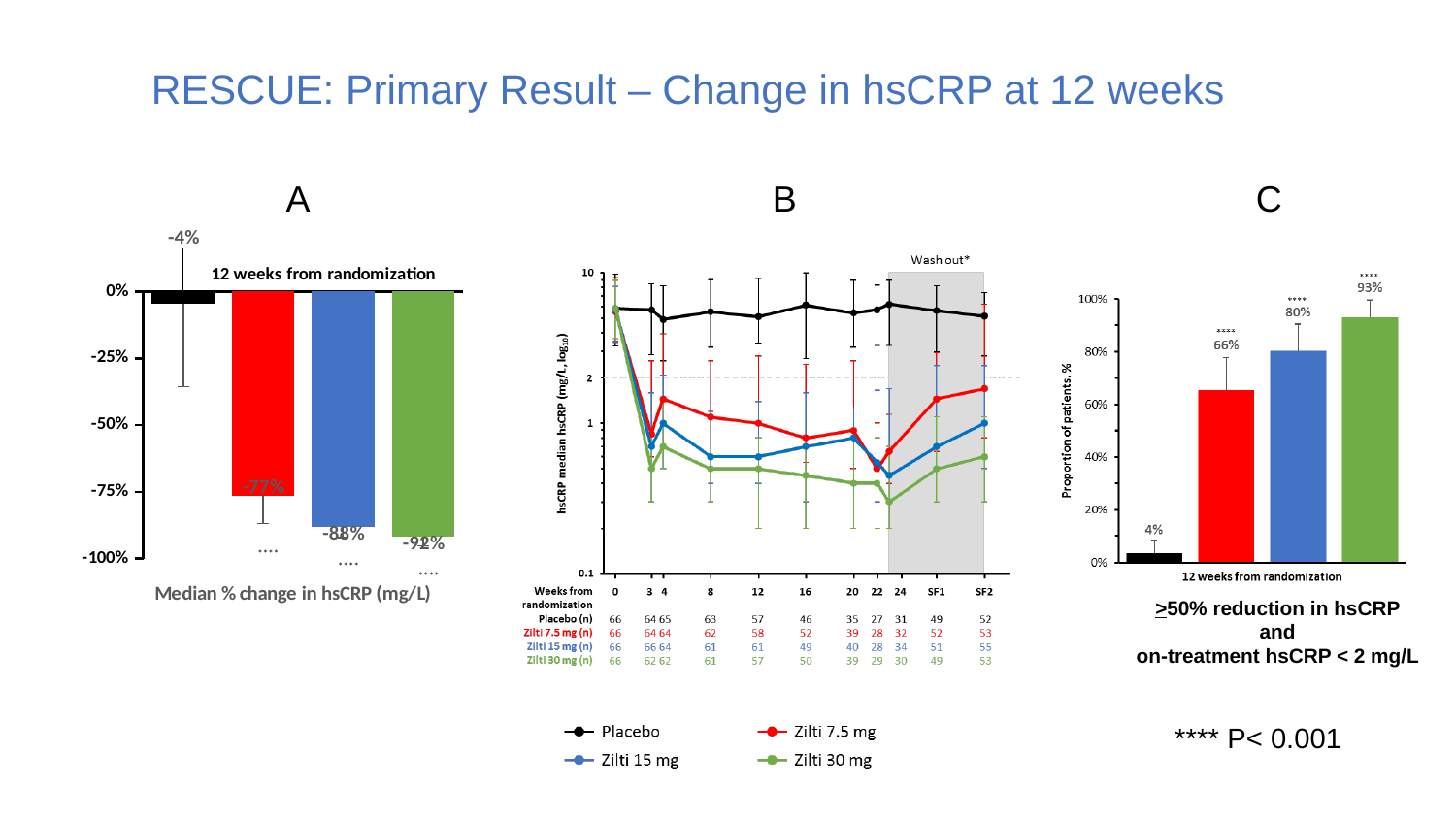
In chart A, what is the median % change in hsCRP shown for the red bar? -77% In chart C, what is the difference between the green bar (93%) and the red bar (66%)? 27 percentage points In chart B, what is the Placebo (n) at week 0? 66 In chart C, which bar has the highest proportion of patients? The green bar (93%) What kind of chart is chart A? Bar chart In chart A, is the value for the blue bar greater or less than -75%? less In chart C, what is the value shown for the black bar? 4% In chart A, what is the median % change in hsCRP shown for the black bar? -4% In chart C, how many bars are plotted? 4 How many series does the legend of chart B list? 4 In chart B, at week 12, which series has the higher median hsCRP: Placebo or Zilti 30 mg? Placebo In chart C, what is the value shown for the green bar? 93%